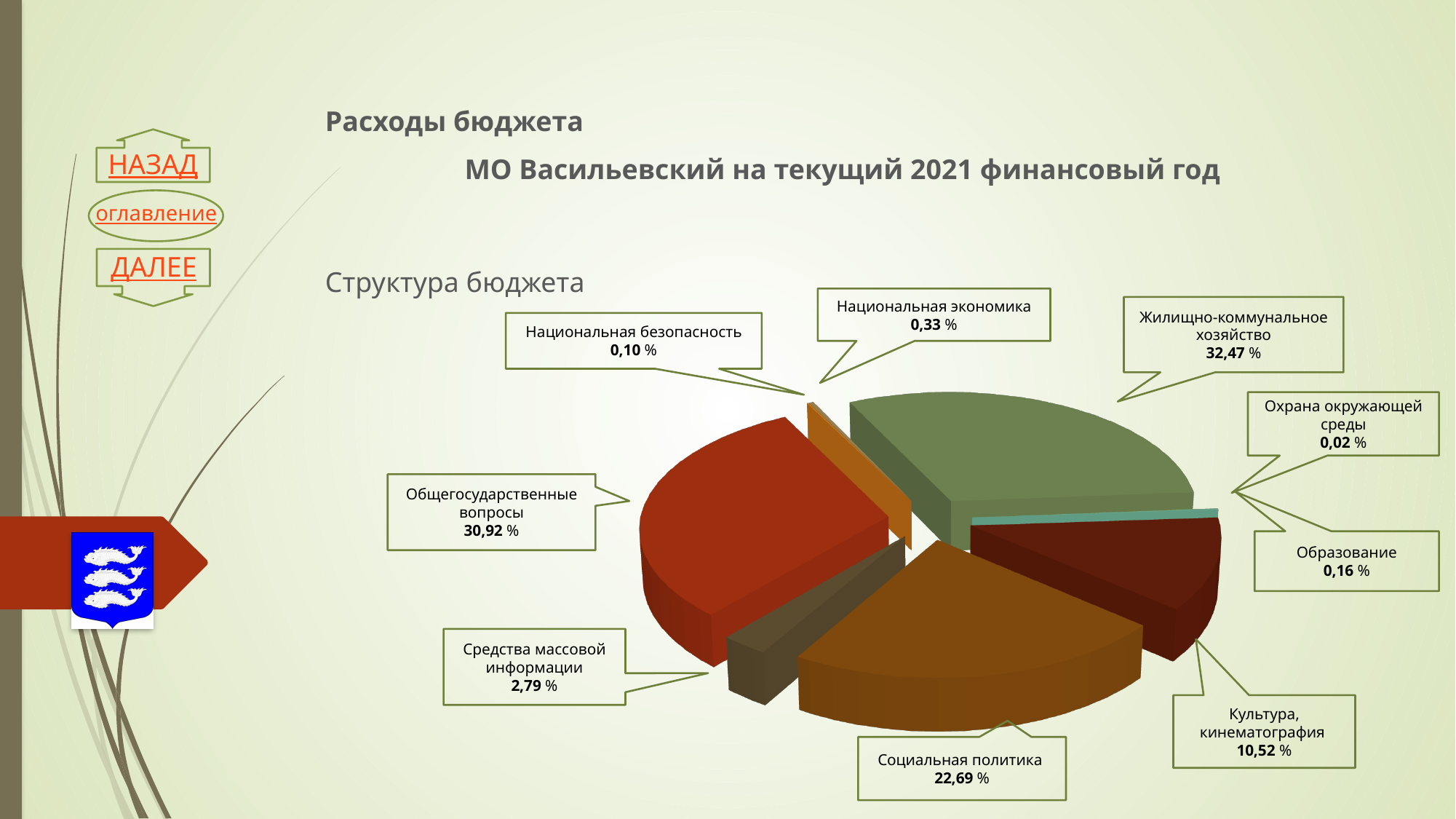
What is the value for Жилищно-коммунальное хозяйство? 32,47 % What is the difference between the values for Социальная политика and Культура, кинематография? 12,17 % What kind of chart is shown on the slide? Pie chart How many categories are shown in the pie chart? 9 What share of the pie does Социальная политика take? 22,69 % What is the value for Средства массовой информации? 2,79 % Which is larger: Национальная экономика or Образование? Национальная экономика What is the value for Общегосударственные вопросы? 30,92 % What is the difference between the values for Жилищно-коммунальное хозяйство and Общегосударственные вопросы? 1,55 % Which category has the largest share of the pie? Жилищно-коммунальное хозяйство Which category has the smallest share of the pie? Охрана окружающей среды What is the value for Культура, кинематография? 10,52 %